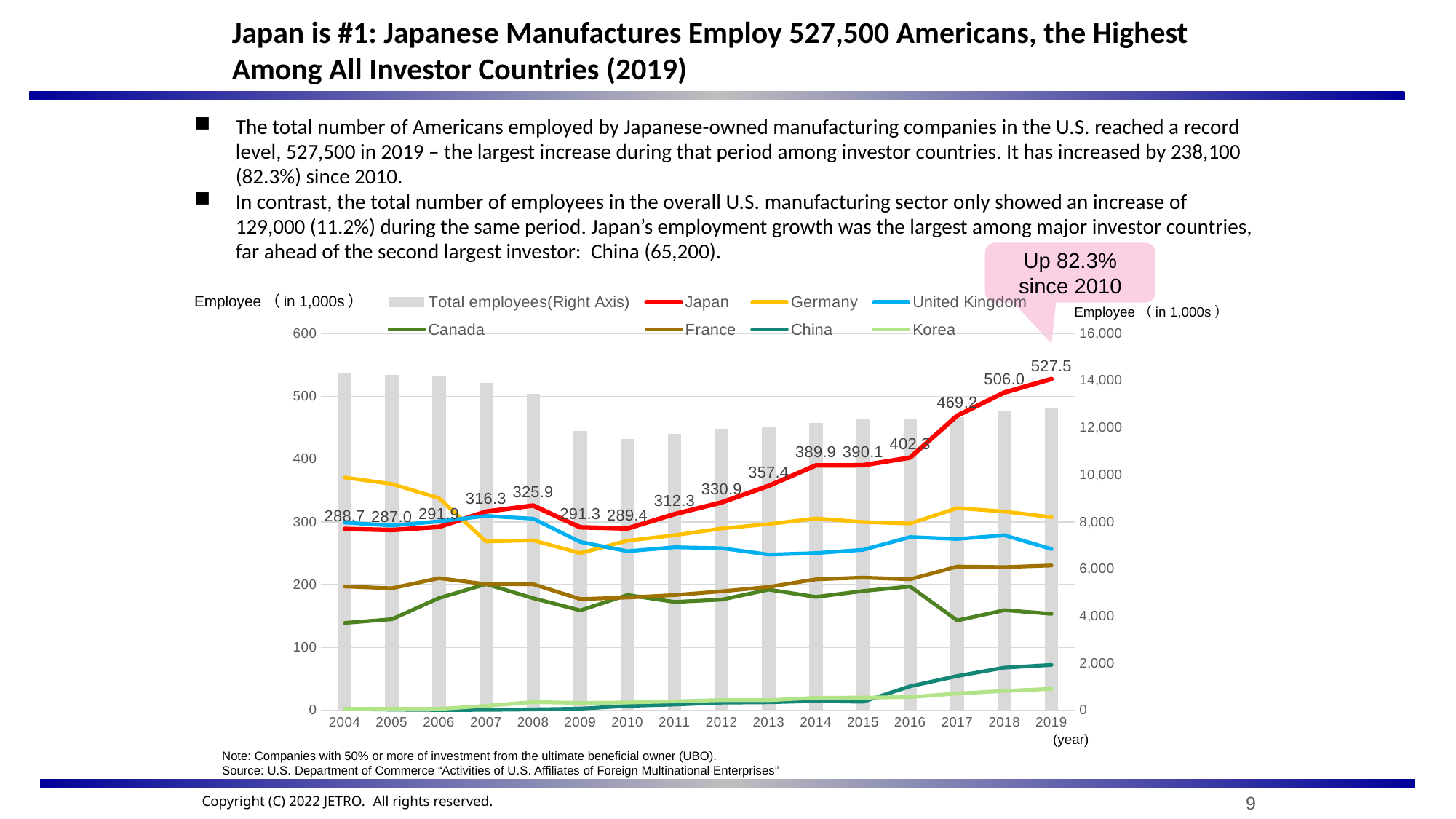
How many series does the legend list? 8 What is the difference between the Japan values for 2018 and 2017? 36.8 What is the value for Japan in 2010? 289.4 What is the value for Japan in 2017? 469.2 In which year does the Japan series reach its highest value? 2019 How many years are shown on the x axis? 16 What kind of chart is this? Combination bar and line chart In which year does the Japan series have its lowest value? 2005 By how much did the Japan value increase from 2010 to 2019? 238.1 What is the value for Japan in 2019? 527.5 Which year has the larger Japan value, 2008 or 2009? 2008 Is the value for Germany in 2004 greater or less than 300? greater